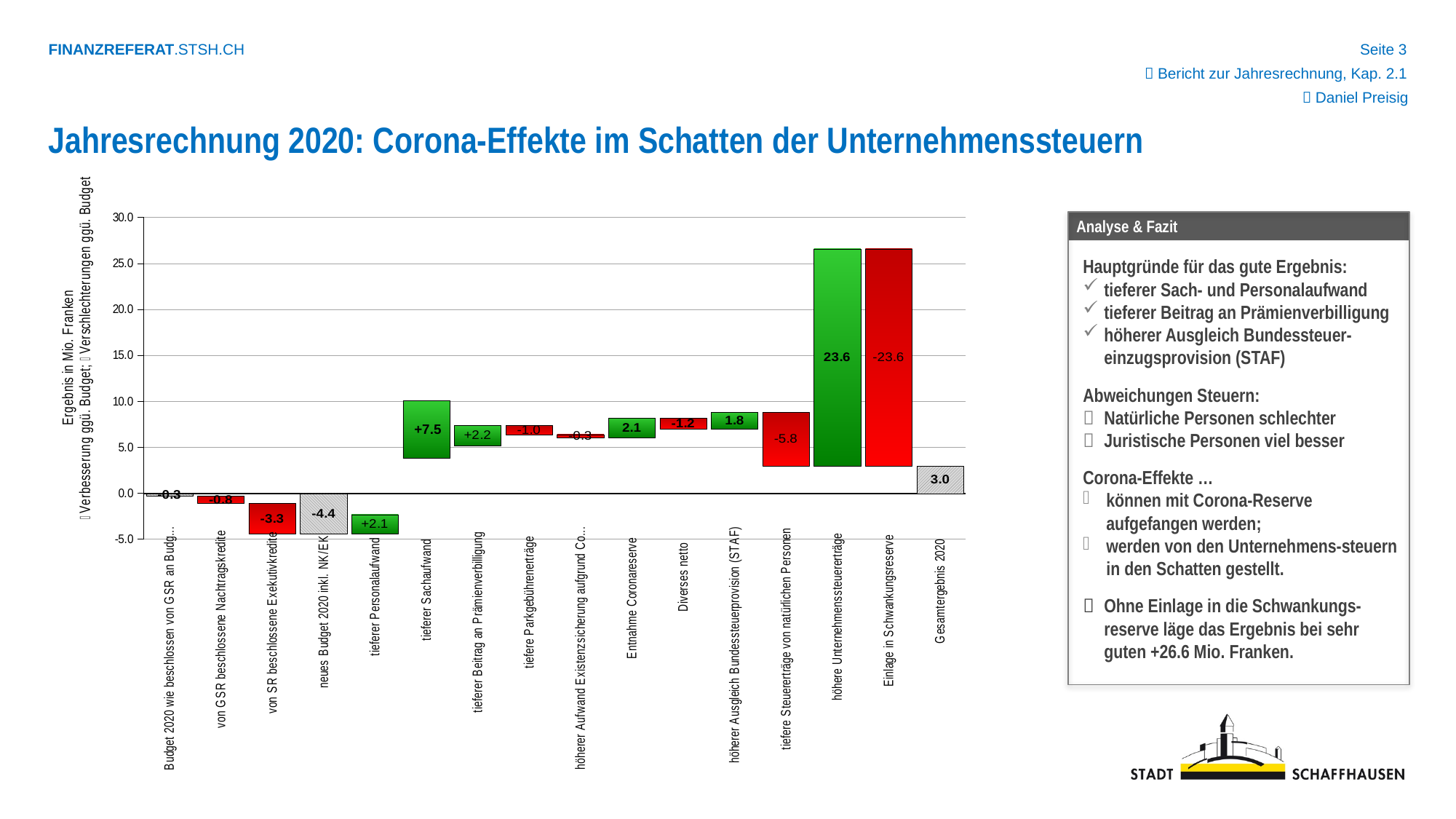
Which category has the highest (most positive) value? höhere Unternehmenssteuererträge How many categories are shown on the x axis of the chart? 16 What is the difference between the values for 'tieferer Sachaufwand' (+7.5) and 'tieferer Beitrag an Prämienverbilligung' (+2.2)? 5.3 Which category has the lowest (most negative) value? Einlage in Schwankungsreserve What is the value shown for 'Gesamtergebnis 2020'? 3.0 What is the value shown for 'neues Budget 2020 inkl. NK/EK'? -4.4 What is the value shown for 'höhere Unternehmenssteuererträge'? 23.6 Which is larger in absolute terms: the value for 'Entnahme Coronareserve' or the value for 'Diverses netto'? Entnahme Coronareserve What kind of chart is shown on the slide? Bar chart (waterfall) What is the value shown for 'tieferer Sachaufwand'? +7.5 What is the value shown for 'tiefere Steuererträge von natürlichen Personen'? -5.8 What is the value shown for 'Einlage in Schwankungsreserve'? -23.6